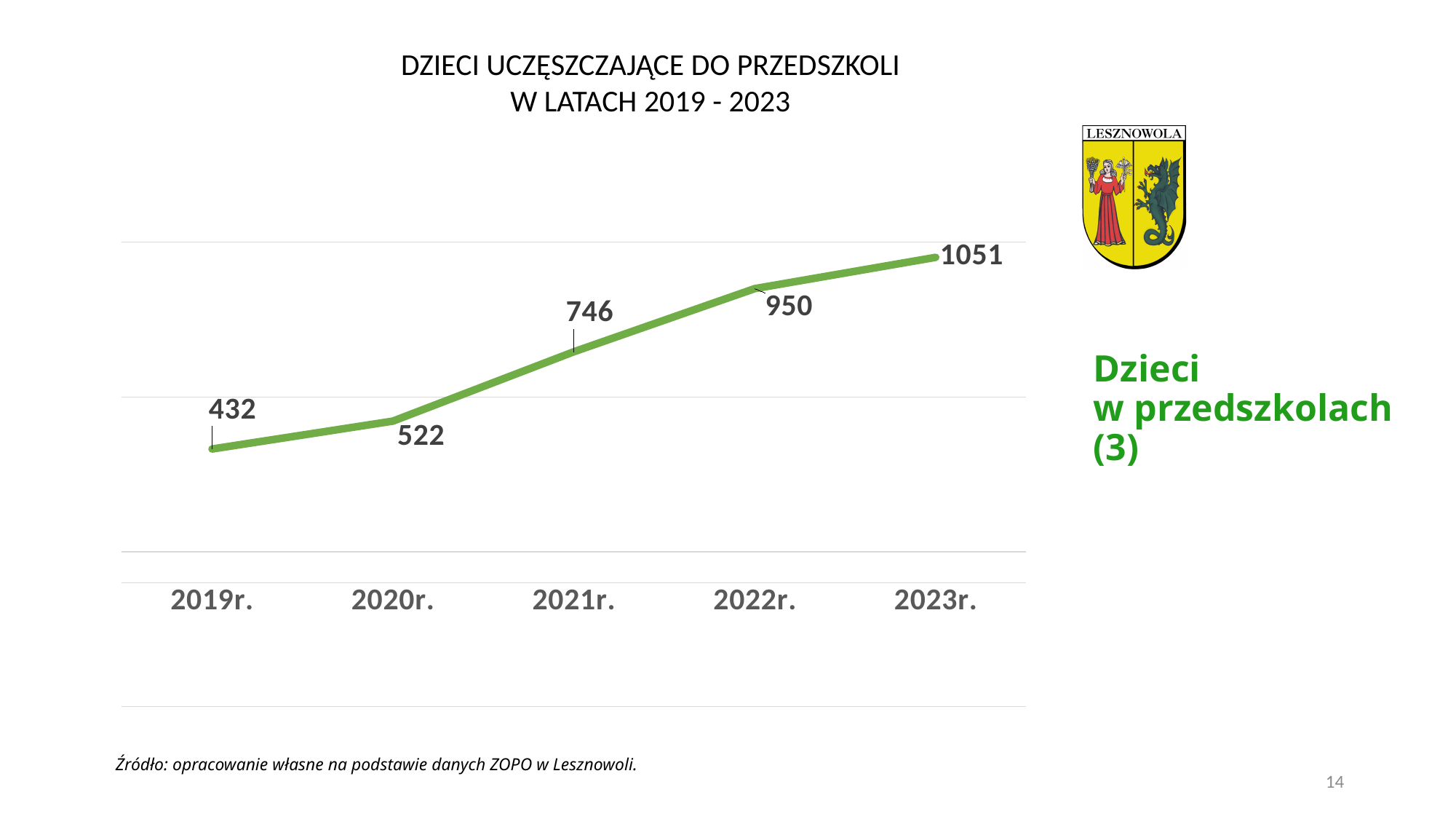
How many years are plotted on the chart? 5 Do the values rise or fall from 2019r. to 2023r.? rise What kind of chart is shown? line chart What is the difference between the values for 2022r. and 2021r.? 204 What is the title of the chart? DZIECI UCZĘSZCZAJĄCE DO PRZEDSZKOLI W LATACH 2019 - 2023 Which year has the highest value? 2023r. What is the value for 2023r.? 1051 What is the value for 2021r.? 746 Which is larger, the value for 2020r. or the value for 2021r.? 2021r. What is the difference between the values for 2023r. and 2019r.? 619 Which year has the lowest value? 2019r. What is the value for 2019r.? 432